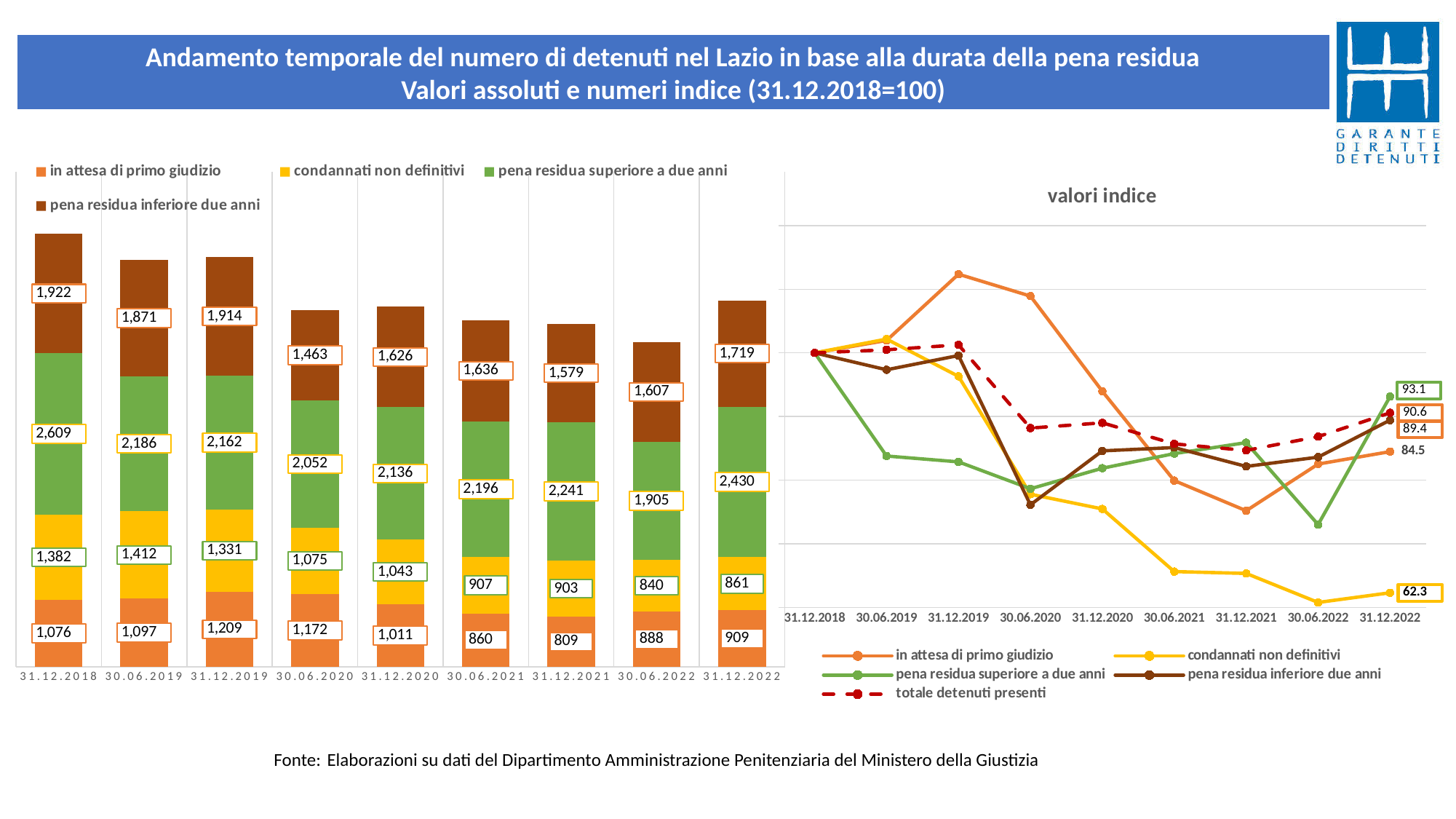
How many dates are shown on the x axis of the left bar chart? 9 In the left bar chart, at which date is 'pena residua superiore a due anni' highest? 31.12.2018 In the left bar chart, what is the total number of detainees at 31.12.2022 (sum of the four segments)? 5,919 In the left bar chart, what is the value for 'pena residua superiore a due anni' at 31.12.2022? 2,430 In the 'valori indice' chart, which series has the highest index value at 31.12.2022? pena residua superiore a due anni In the left bar chart, at which date is 'in attesa di primo giudizio' lowest? 31.12.2021 In the left bar chart, is 'condannati non definitivi' larger at 30.06.2019 or at 31.12.2019? 30.06.2019 How many series does the legend of the 'valori indice' chart list? 5 In the left bar chart, what is the difference between 'pena residua inferiore due anni' at 31.12.2018 and at 31.12.2022? 203 In the left bar chart, what is the value for 'in attesa di primo giudizio' at 31.12.2019? 1,209 In the 'valori indice' chart, what is the index value for 'condannati non definitivi' at 31.12.2022? 62.3 What kind of chart is the left chart showing absolute values? Stacked bar chart